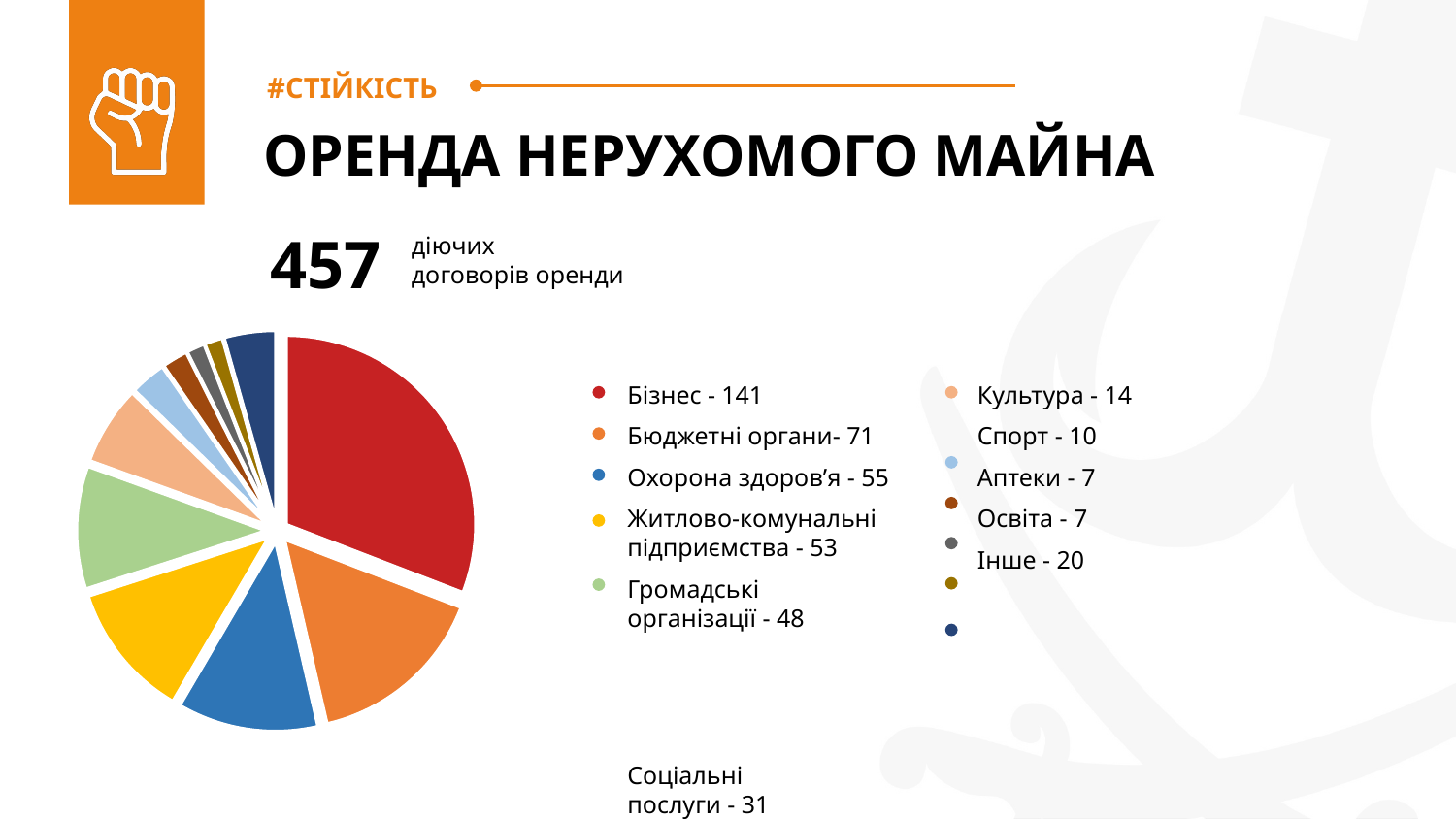
What is the value for Бізнес in the pie chart? 141 What is the value for Інше? 20 What is the value for Соціальні послуги? 31 How many active lease agreements (діючих договорів оренди) are reported in total on the slide? 457 What is the difference between the values for Бізнес and Бюджетні органи? 70 What is the value for Житлово-комунальні підприємства? 53 What is the value for Бюджетні органи? 71 Which is larger, the value for Охорона здоров'я or for Громадські організації? Охорона здоров'я What type of chart is shown on the slide? Pie chart Which categories have the smallest value in the pie chart? Аптеки and Освіта Which category has the largest slice of the pie chart? Бізнес What is the title of the slide containing the pie chart? ОРЕНДА НЕРУХОМОГО МАЙНА